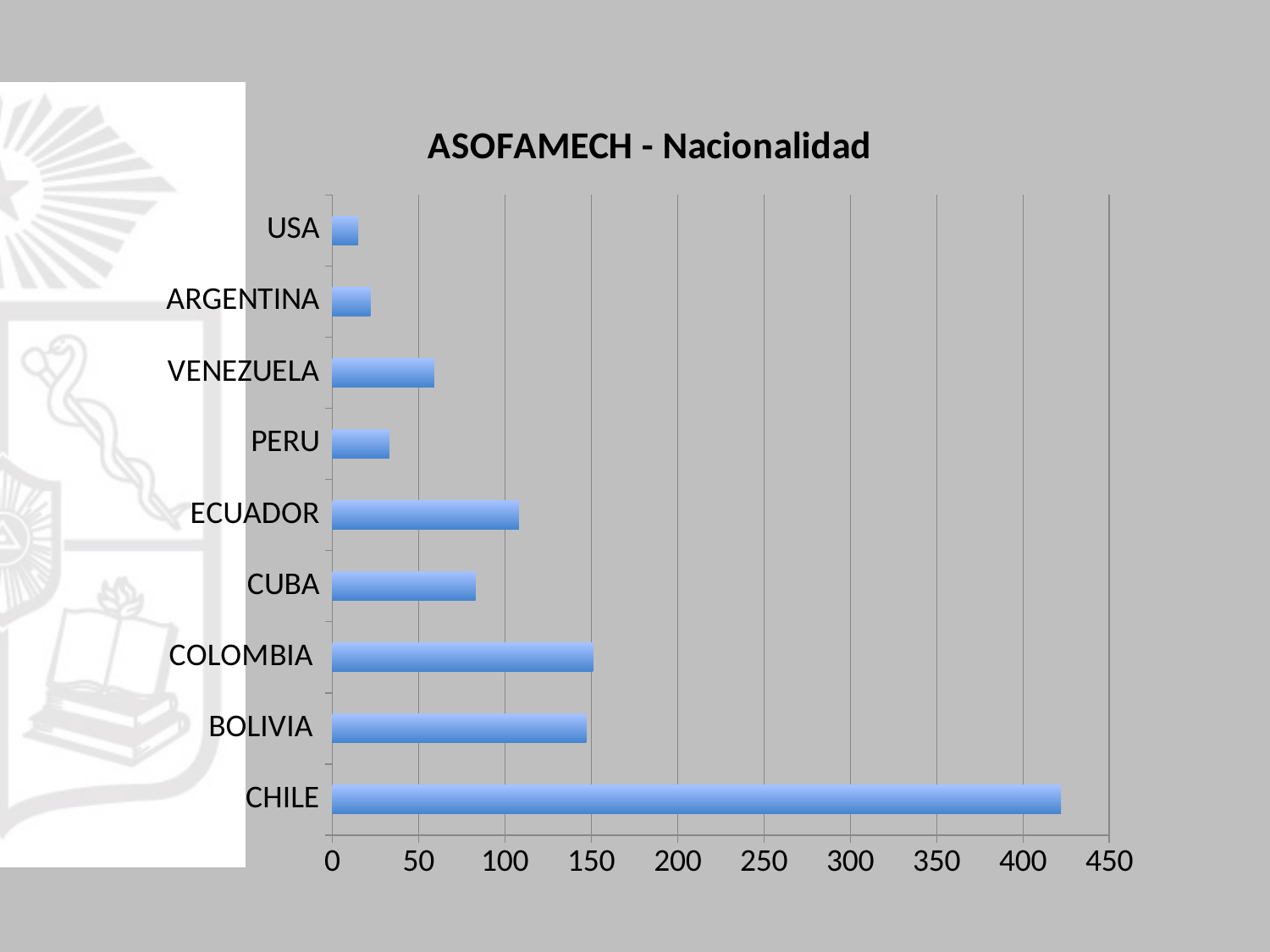
Is the value for CHILE greater or less than 400? greater Is the value for VENEZUELA greater or less than 50? greater What is the title of the chart? ASOFAMECH - Nacionalidad Is the value for CUBA greater or less than 100? less Which has a larger value, ECUADOR or CUBA? ECUADOR Which nationality has the highest value in the chart? CHILE Which nationality has the lowest value in the chart? USA What type of chart is shown on the slide? bar chart Which has a larger value, VENEZUELA or ARGENTINA? VENEZUELA How many nationalities (categories) are shown in the chart? 9